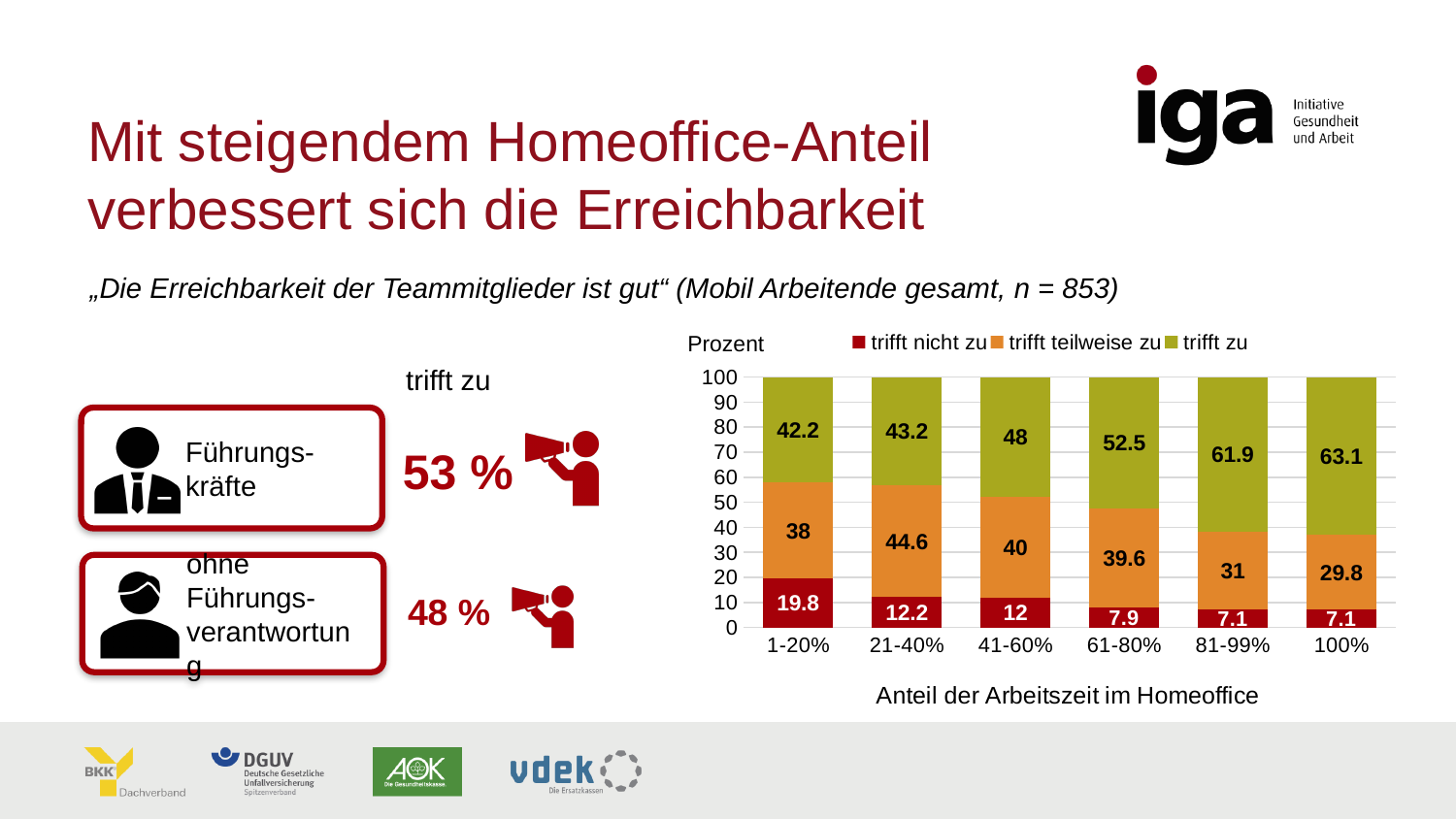
How many series does the legend list? 3 What kind of chart is shown on the slide? stacked bar chart What is the total of the stacked bar for the 41-60% category? 100 What is the difference between the "trifft zu" values for 100% and 1-20%? 20.9 What is the value of "trifft nicht zu" for the 21-40% category? 12.2 How many categories are shown on the x axis? 6 Does the value of "trifft nicht zu" rise or fall from 1-20% to 100%? fall Which category has the lowest value for "trifft teilweise zu"? 100% Which category has the highest value for "trifft zu"? 100% What is the value of "trifft teilweise zu" for the 81-99% category? 31 Which is larger: "trifft nicht zu" for 1-20% or for 61-80%? 1-20% What is the value of "trifft zu" for the 1-20% category? 42.2